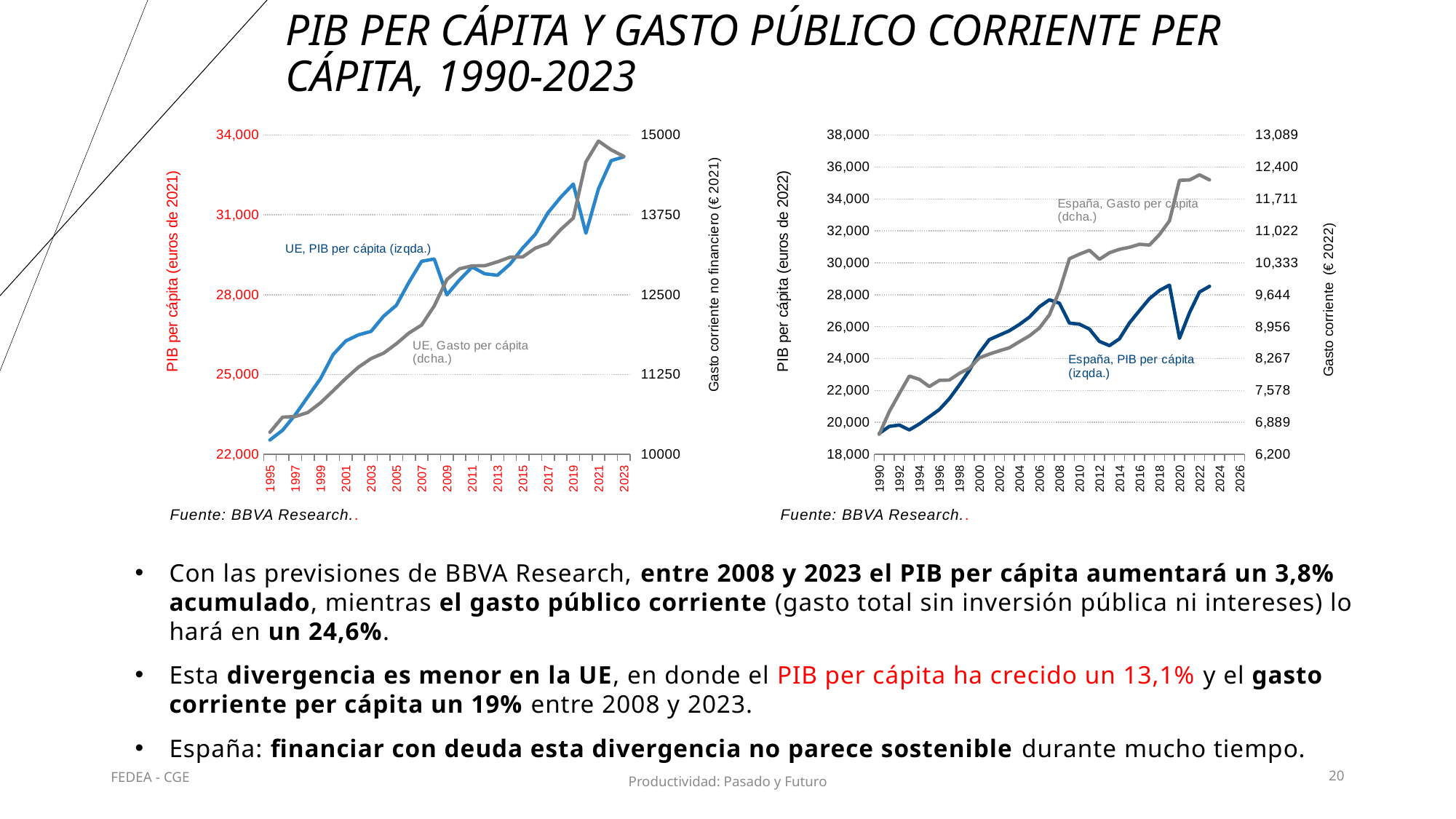
What source is cited below both charts? BBVA Research How many series are plotted on the left chart (UE)? 2 What kind of chart is the right chart (España)? line chart What kind of chart is the left chart (UE)? line chart How many series are plotted on the right chart (España)? 2 On the right chart (España), does España Gasto per cápita overall rise or fall from 1990 to 2023? rise On the right chart (España), is the value of España PIB per cápita in 2023 greater or less than 26,000? greater On the left chart (UE), is the value of UE PIB per cápita in 1995 greater or less than 25,000? less On the left chart (UE), is the value of UE PIB per cápita in 2023 greater or less than 31,000? greater